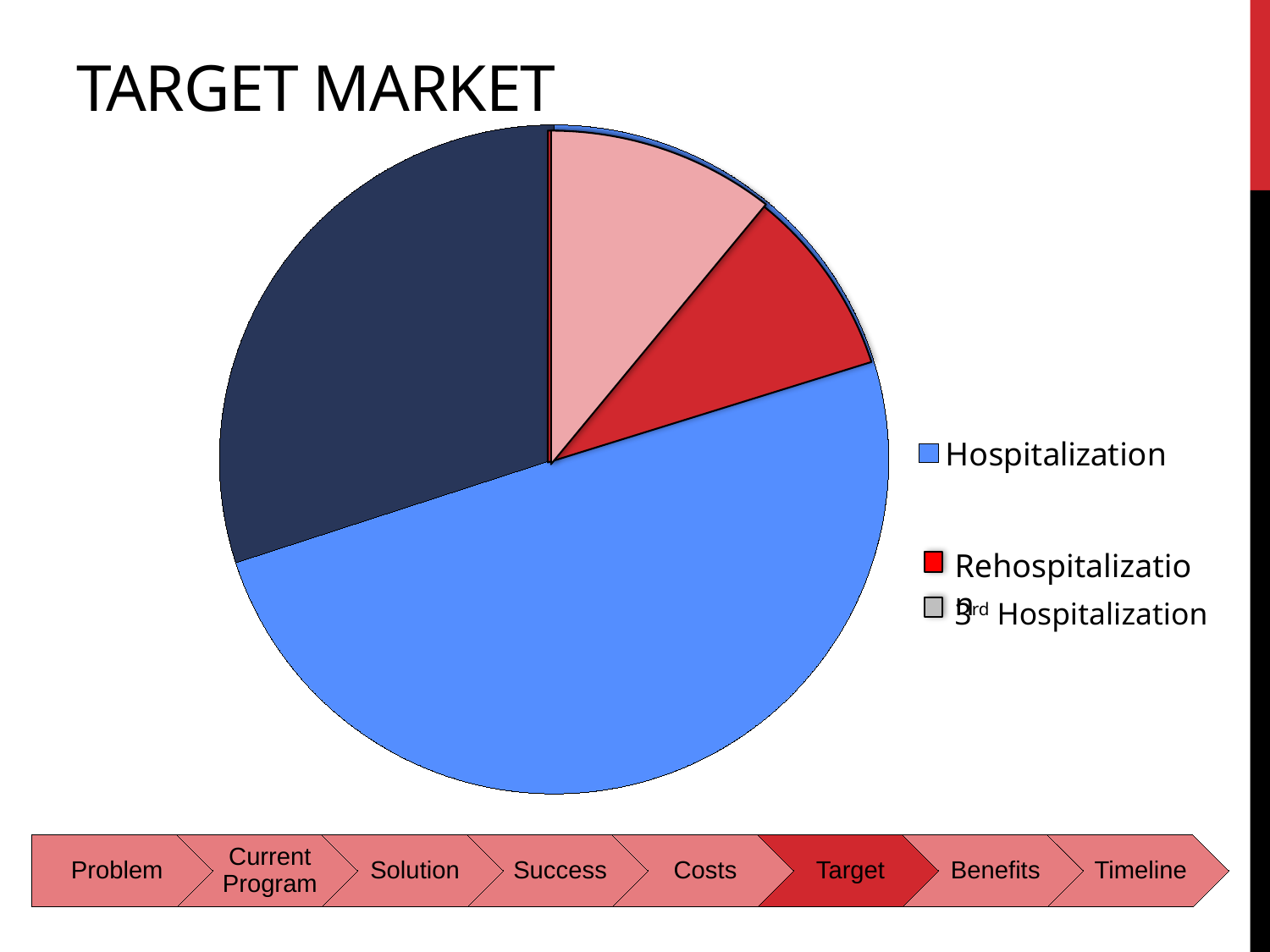
How many slices does the pie chart have? 4 What kind of chart is shown on the slide? pie chart Which legend category has the smallest slice of the pie? Rehospitalization What colour is the Rehospitalization slice in the pie chart? red What is the title of the slide containing the pie chart? TARGET MARKET Which slice is larger, 3rd Hospitalization or Rehospitalization? 3rd Hospitalization Which slice is larger, Hospitalization or Rehospitalization? Hospitalization How many entries does the legend of the pie chart list? 3 Which legend category has the largest slice of the pie? Hospitalization